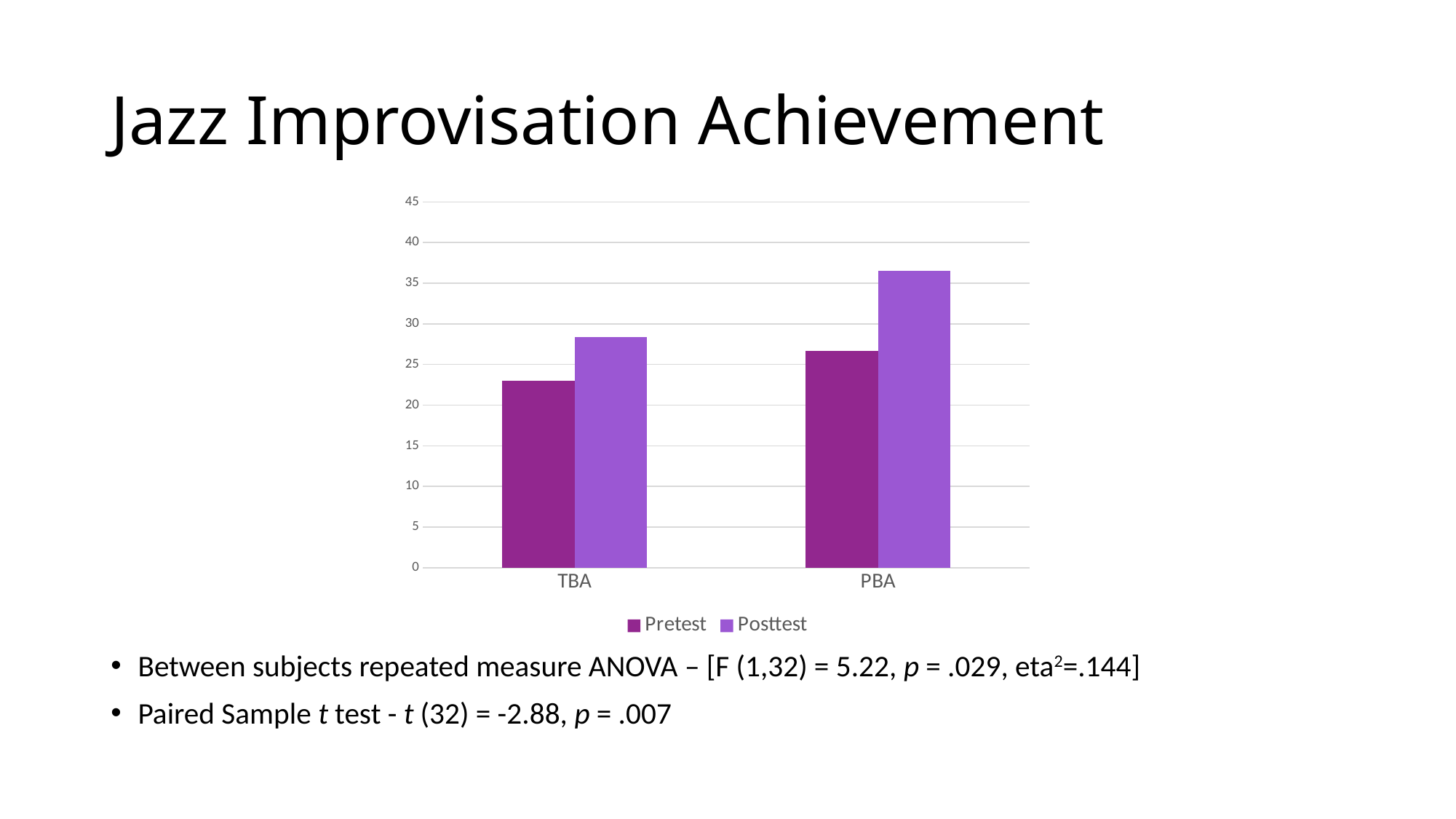
Is the Posttest value for PBA greater or less than 35? greater Is the Posttest value for TBA greater or less than 25? greater Is the Pretest value for TBA greater or less than 25? less How many series does the legend list? 2 What kind of chart is shown on the slide? bar chart Which bar is the highest in the chart? PBA Posttest Which group has the larger Posttest value, TBA or PBA? PBA For PBA, which is larger, the Pretest or the Posttest value? Posttest Which bar is the lowest in the chart? TBA Pretest Which series are listed in the legend? Pretest and Posttest How many categories are shown on the x axis? 2